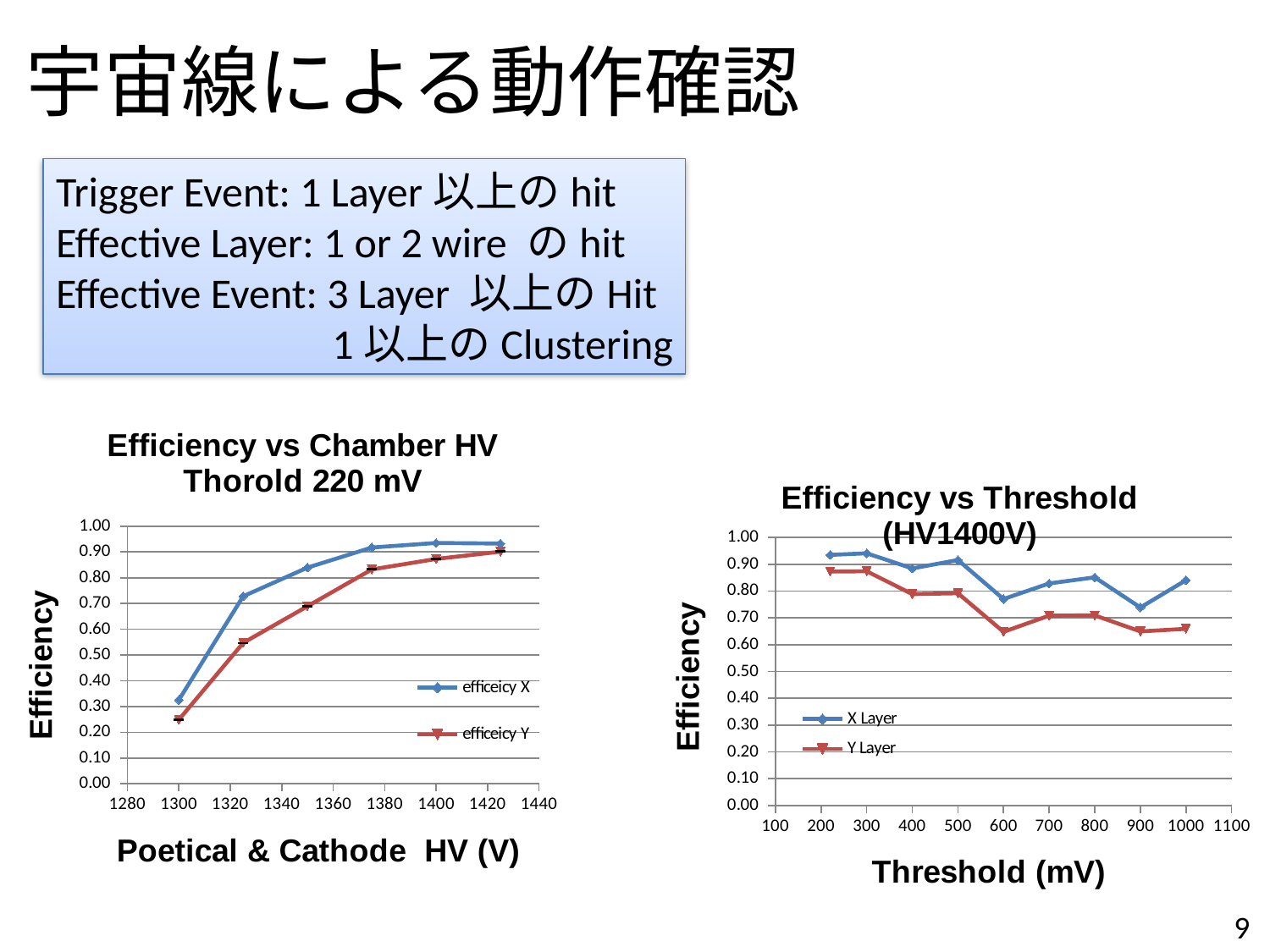
What kind of chart is the 'Efficiency vs Chamber HV Thorold 220 mV' chart on the left? line chart What are the two legend entries in the 'Efficiency vs Threshold (HV1400V)' chart? X Layer and Y Layer In the 'Efficiency vs Threshold (HV1400V)' chart, which series has the larger value at 900 mV, 'X Layer' or 'Y Layer'? X Layer In the 'Efficiency vs Chamber HV Thorold 220 mV' chart, how many data points does the 'efficeicy X' series have? 6 How many series does the legend of the 'Efficiency vs Chamber HV Thorold 220 mV' chart list? 2 In the 'Efficiency vs Threshold (HV1400V)' chart, how many data points does the 'X Layer' series have? 9 In the 'Efficiency vs Chamber HV Thorold 220 mV' chart, which series has the larger value at 1325 V, 'efficeicy X' or 'efficeicy Y'? efficeicy X In the 'Efficiency vs Chamber HV Thorold 220 mV' chart, is the 'efficeicy X' value at 1300 V greater or less than 0.50? less In the 'Efficiency vs Chamber HV Thorold 220 mV' chart, do the efficiency values rise or fall as HV increases? rise In the 'Efficiency vs Chamber HV Thorold 220 mV' chart, is the 'efficeicy Y' value at 1425 V greater or less than 0.80? greater What kind of chart is the 'Efficiency vs Threshold (HV1400V)' chart on the right? line chart In the 'Efficiency vs Threshold (HV1400V)' chart, is the 'Y Layer' value at 600 mV greater or less than 0.70? less